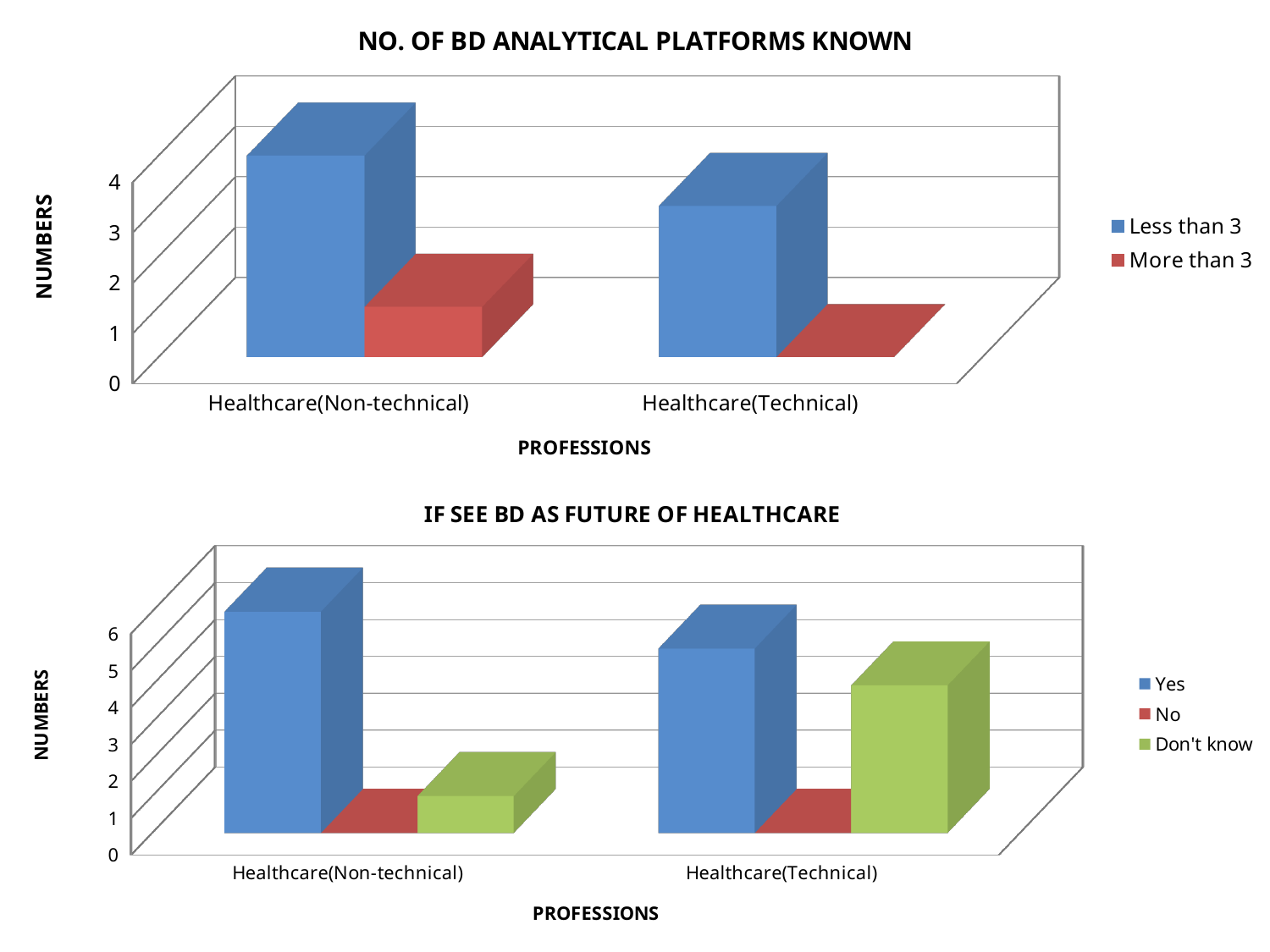
In the top chart, is the More than 3 value for Healthcare(Technical) greater or less than 1? less In the top chart, for Healthcare(Non-technical), which is larger: Less than 3 or More than 3? Less than 3 What kind of chart is the top chart titled "NO. OF BD ANALYTICAL PLATFORMS KNOWN"? Bar chart In the bottom chart titled "IF SEE BD AS FUTURE OF HEALTHCARE", how many series does the legend list? 3 In the bottom chart, for Healthcare(Technical), which is larger: Yes or Don't know? Yes In the bottom chart, does the Yes series rise or fall from Healthcare(Non-technical) to Healthcare(Technical)? fall In the top chart, is the Less than 3 value for Healthcare(Non-technical) greater or less than 2? greater In the top chart, how many profession categories are shown on the x axis? 2 In the bottom chart, is the Yes value for Healthcare(Non-technical) greater or less than 4? greater What is the title of the vertical axis on the bottom chart? NUMBERS In the top chart, which bar is the tallest? Less than 3 for Healthcare(Non-technical) In the top chart, how many series does the legend list? 2